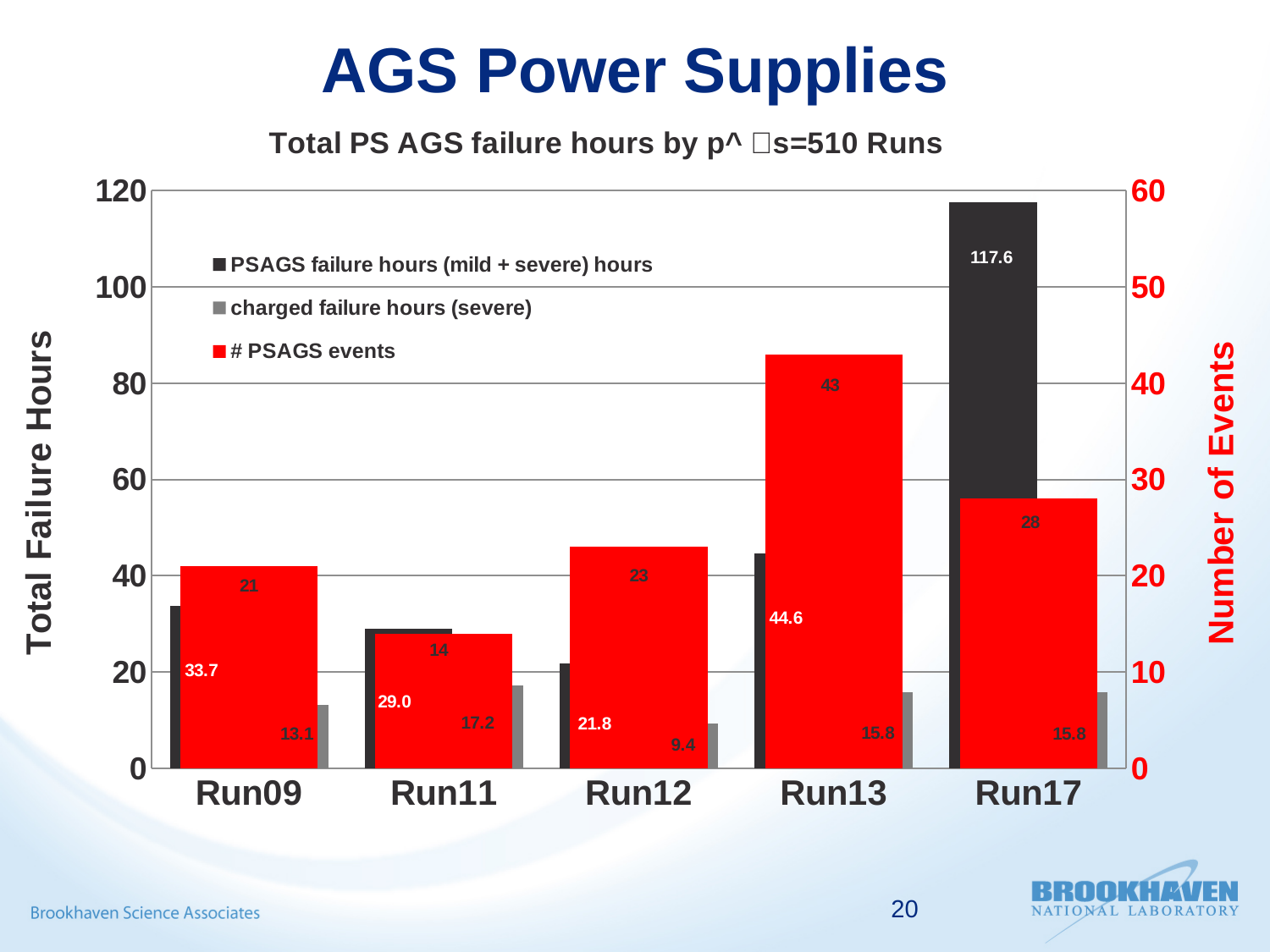
How many # PSAGS events are shown for Run13? 43 What kind of chart is shown on the slide? bar chart Is the PSAGS failure hours (mild + severe) value for Run13 greater or less than 40? greater Which is larger, the # PSAGS events for Run09 or for Run12? Run12 What is the PSAGS failure hours (mild + severe) value for Run17? 117.6 How many runs are shown on the x axis? 5 What is the charged failure hours (severe) value for Run11? 17.2 Which run has the fewest # PSAGS events? Run11 What is the difference in PSAGS failure hours (mild + severe) between Run17 and Run13? 73.0 Which run has the lowest charged failure hours (severe)? Run12 Which run has the highest PSAGS failure hours (mild + severe)? Run17 How many series does the legend list? 3